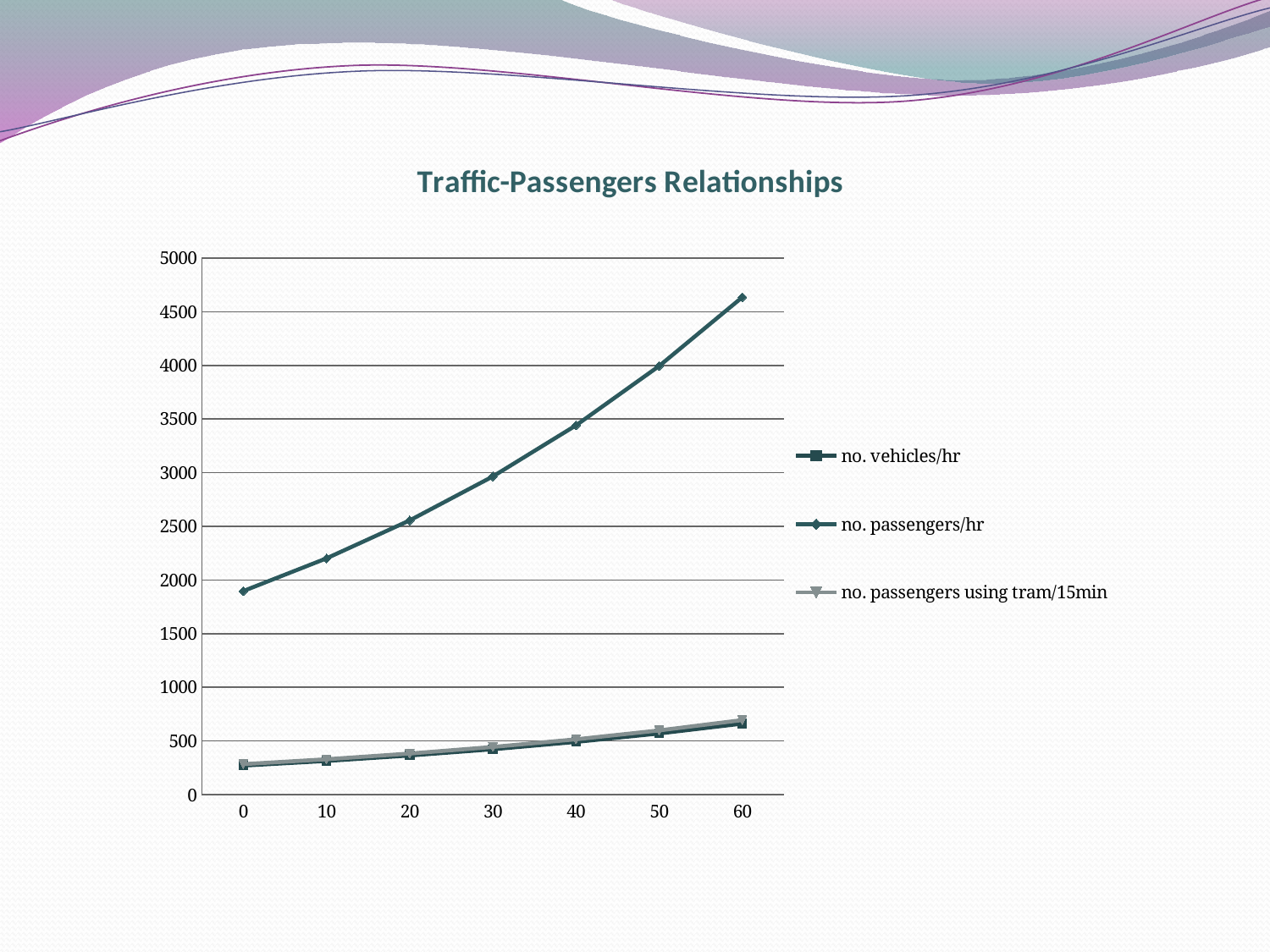
Is the value for no. vehicles/hr at x = 60 greater or less than 1000? less Is the value for no. passengers/hr at x = 30 greater or less than 2500? greater Is the value for no. passengers/hr at x = 0 greater or less than 2000? less How many x-axis points are plotted for each series? 7 Does the no. passengers/hr series rise or fall as the x-axis value increases from 0 to 60? rise Which series has the highest values across the chart? no. passengers/hr What kind of chart is shown on the slide? line chart How many series does the legend list? 3 At x = 60, which is larger: no. passengers/hr or no. vehicles/hr? no. passengers/hr What is the title of the chart? Traffic-Passengers Relationships